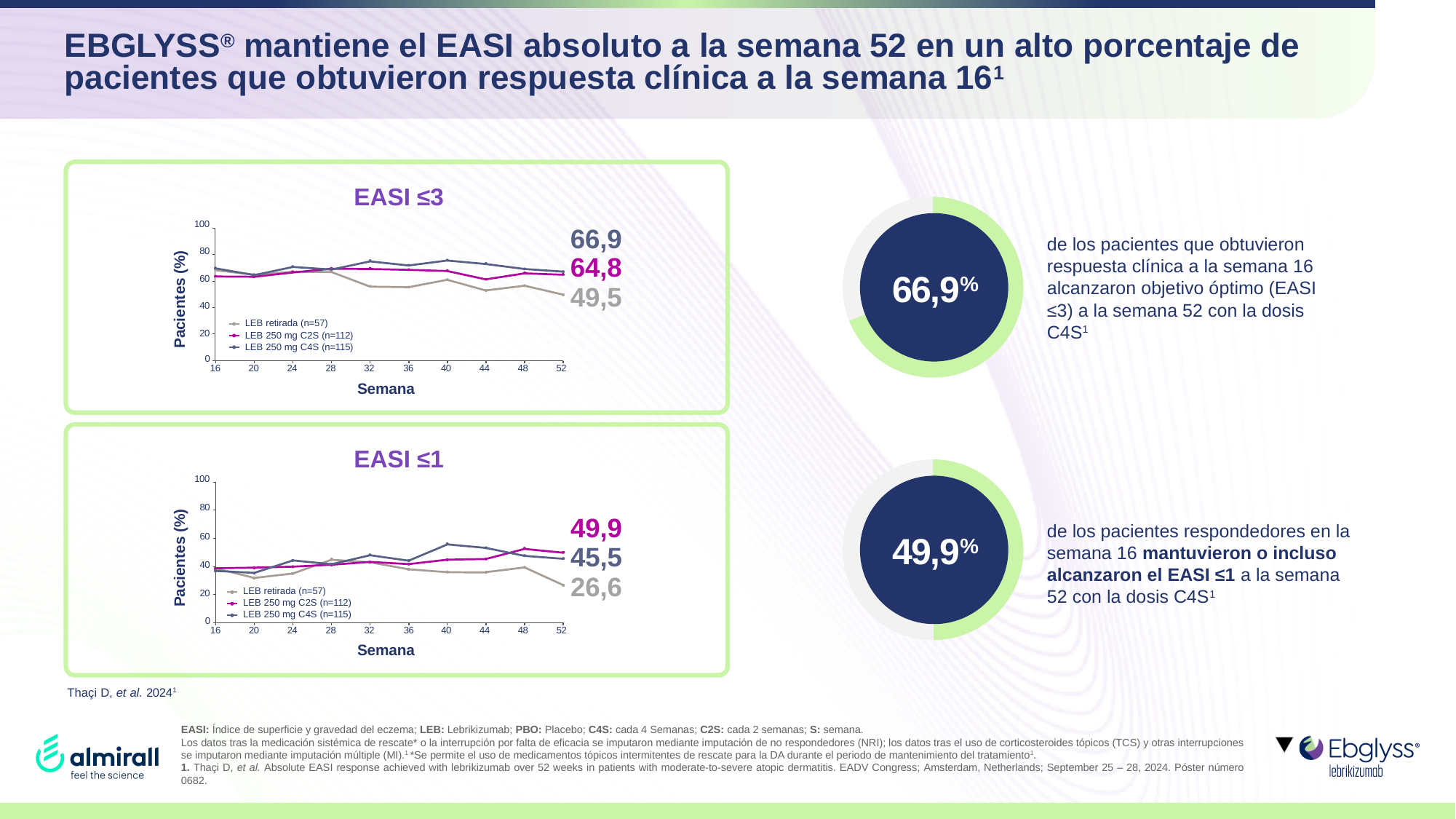
In the EASI ≤1 chart, what is the value for LEB retirada (n=57) at week 52? 26,6 In the EASI ≤1 chart, is the value for LEB retirada (n=57) at week 52 greater or less than 40? less In the EASI ≤3 chart, which series has the highest value at week 52? LEB 250 mg C4S (n=115) In the EASI ≤3 chart, what is the difference between the week 52 values of LEB 250 mg C4S (n=115) and LEB retirada (n=57)? 17,4 In the EASI ≤1 chart, which is larger at week 52: LEB 250 mg C2S (n=112) or LEB retirada (n=57)? LEB 250 mg C2S (n=112) In the EASI ≤3 chart, what is the value for LEB retirada (n=57) at week 52? 49,5 In the EASI ≤3 chart, what is the value for LEB 250 mg C4S (n=115) at week 52? 66,9 How many series does the legend of the EASI ≤3 chart list? 3 What kind of chart is the EASI ≤1 chart? line chart In the EASI ≤1 chart, which series has the lowest value at week 52? LEB retirada (n=57) In the EASI ≤1 chart, what is the difference between the week 52 values of LEB 250 mg C2S (n=112) and LEB 250 mg C4S (n=115)? 4,4 In the EASI ≤1 chart, what is the value for LEB 250 mg C2S (n=112) at week 52? 49,9